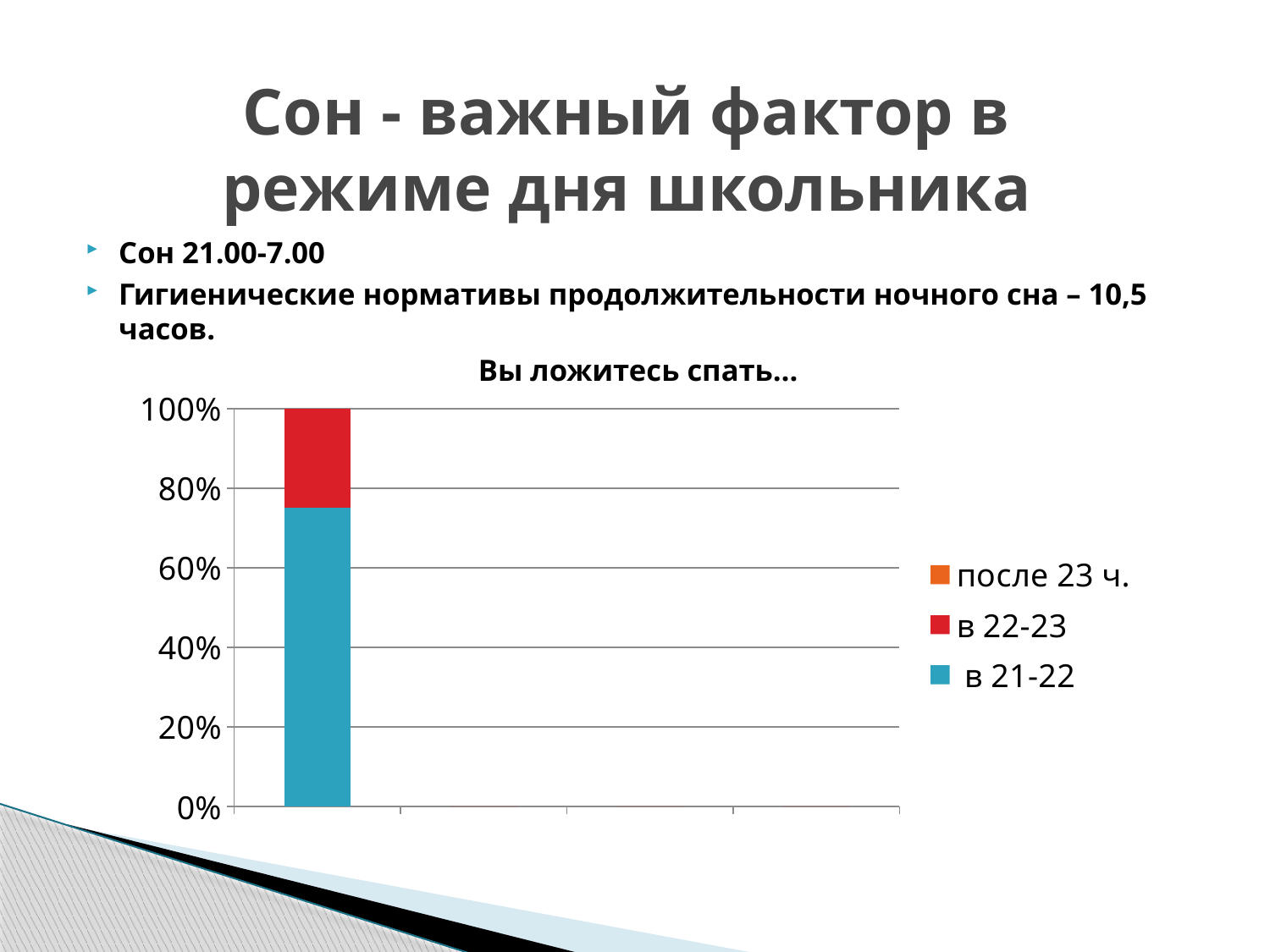
Which is larger, the segment for 'в 21-22' or the segment for 'в 22-23'? в 21-22 Is the share for 'в 21-22' greater or less than 60%? greater Which series takes up the largest share of the bar? в 21-22 Is the share for 'в 22-23' greater or less than 40%? less Is the share for 'в 21-22' greater or less than 80%? less What is the title of the chart? Вы ложитесь спать… How many bars are plotted in the chart? 1 Which series has no visible segment in the bar? после 23 ч. What value does the top of the stacked bar reach on the axis? 100% Which legend entry is shown in blue? в 21-22 How many series does the chart legend list? 3 What kind of chart is shown on the slide? stacked bar chart